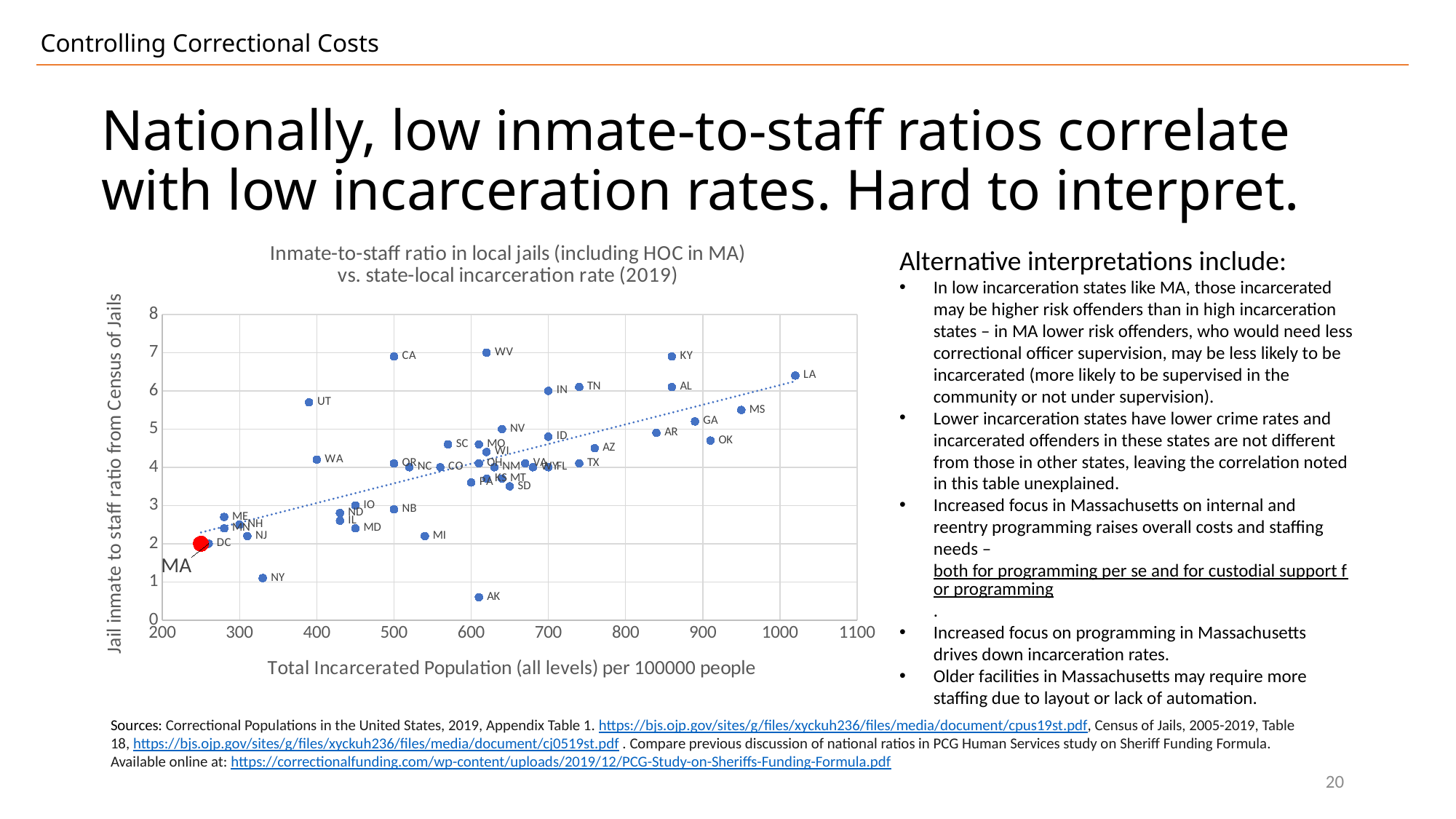
What is the label of the x axis of the chart? Total Incarcerated Population (all levels) per 100000 people What kind of chart is shown on the slide? Scatter plot Which state has a higher jail inmate-to-staff ratio, CA or MI? CA Which state is plotted furthest to the left (lowest incarceration rate) on the chart? MA According to the dotted trend line, does the jail inmate-to-staff ratio rise or fall as the total incarcerated population per 100000 people increases? Rises Which state has the highest total incarcerated population per 100000 people on the chart? LA Is the total incarcerated population per 100000 people for KY greater or less than 800? greater Is the jail inmate-to-staff ratio for UT greater or less than 5? greater Is the jail inmate-to-staff ratio for NY greater or less than 2? less Which state's point is highlighted in red on the chart? MA Which state has the lowest jail inmate-to-staff ratio on the chart? AK